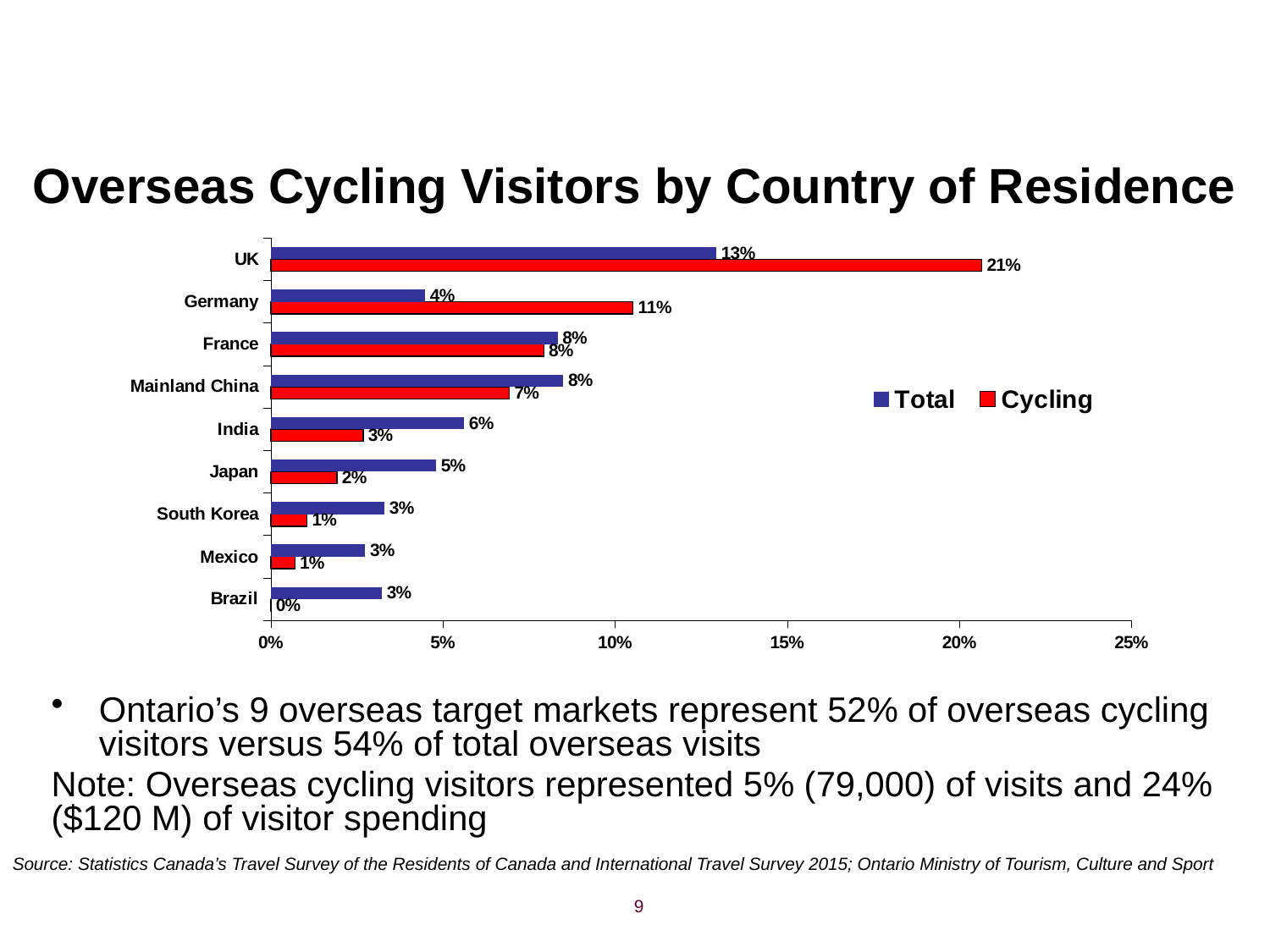
What is the difference between the Cycling and Total values for Germany? 7% What kind of chart is shown on the slide? Bar chart How many series does the legend list? 2 How many countries are shown on the chart? 9 What is the Total value for Germany? 4% What is the Cycling value for Brazil? 0% Which is larger for Japan, the Total value or the Cycling value? Total What is the Cycling value for India? 3% Which country has the highest Cycling value? UK What is the Cycling value for the UK? 21% What is the difference between the Cycling and Total values for the UK? 8% Which country has the lowest Cycling value? Brazil